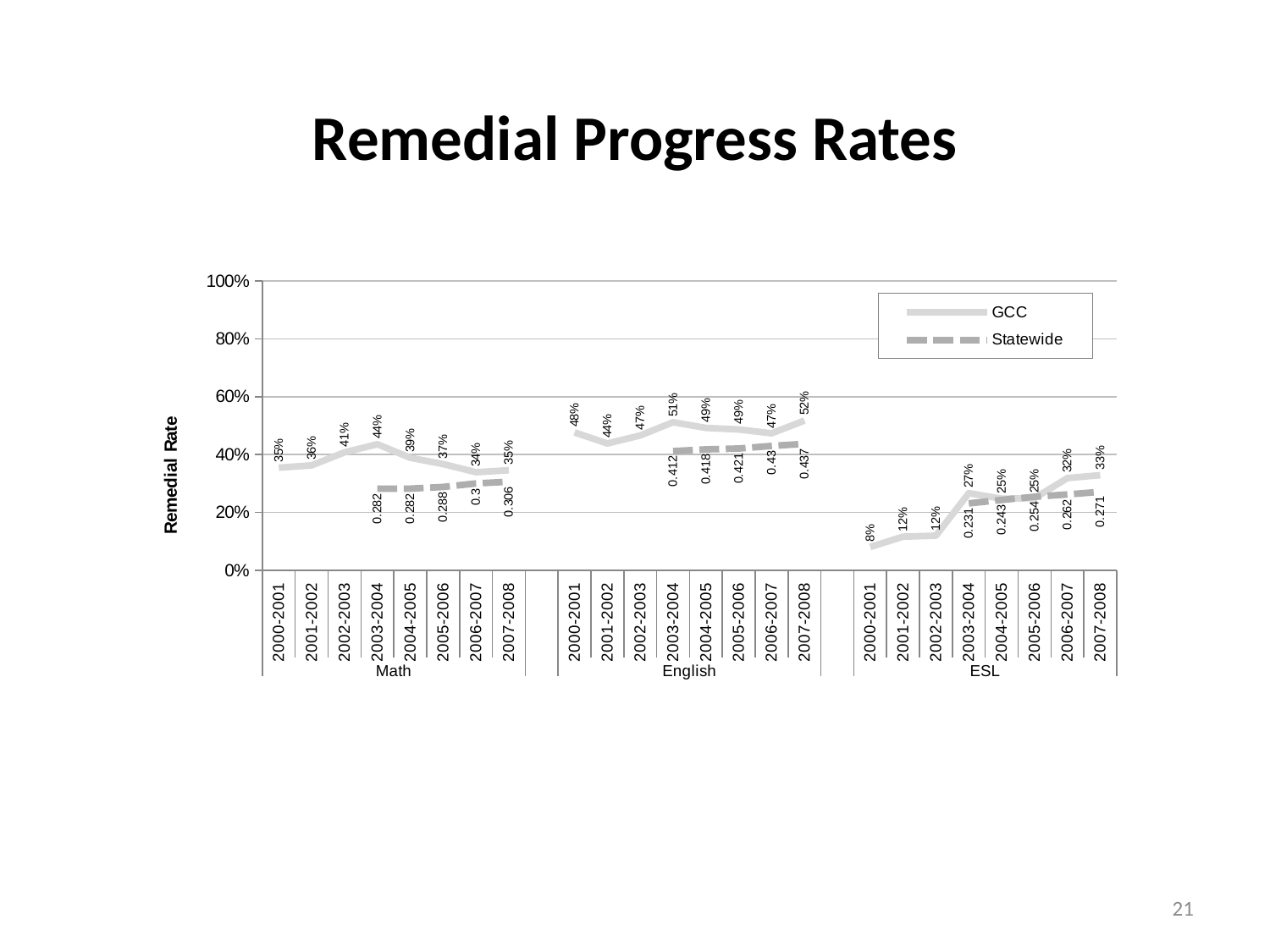
In which year is the GCC English rate highest? 2007-2008 What is the Statewide value shown for English in 2007-2008? 0.437 Is the GCC ESL rate for 2007-2008 greater or less than 40%? less What kind of chart is shown on the slide? line chart How many series does the legend list? 2 Which is larger, the GCC English rate in 2000-2001 or in 2001-2002? 2000-2001 What is the label on the vertical axis of the chart? Remedial Rate In which year is the GCC ESL rate lowest? 2000-2001 What is the difference between the GCC Math rate in 2003-2004 and in 2006-2007? 10% Does the Statewide ESL value rise or fall from 2003-2004 to 2007-2008? rise What is the GCC remedial progress rate for ESL in 2000-2001? 8% What is the GCC remedial progress rate for Math in 2003-2004? 44%